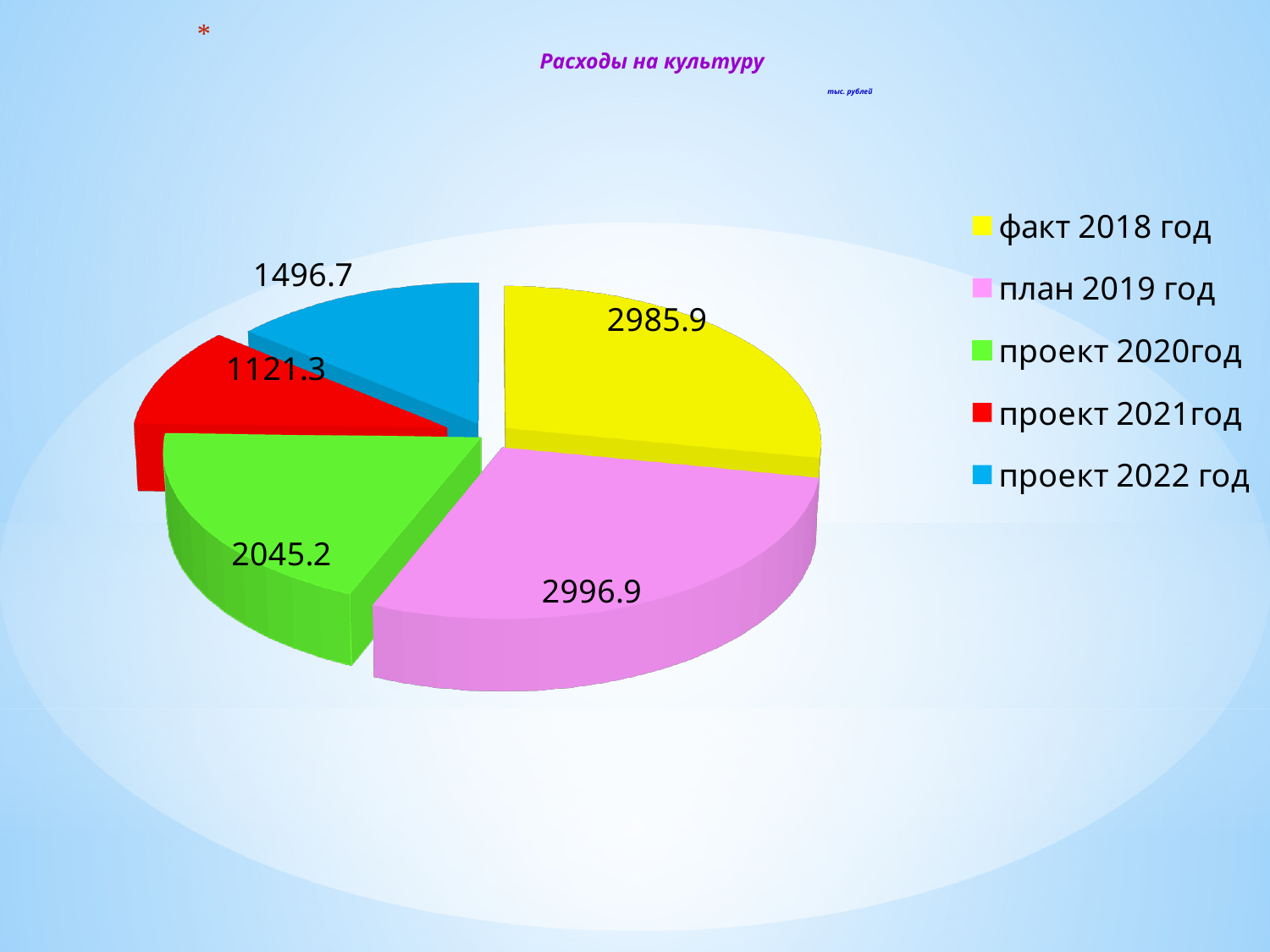
What is the value for проект 2022 год? 1496.7 How many slices does the pie chart have? 5 What is the value for проект 2021год? 1121.3 What is the value for проект 2020год? 2045.2 What kind of chart is shown on the slide? Pie chart What is the difference between the values for проект 2020год and проект 2022 год? 548.5 Which category has the smallest value? проект 2021год What is the value for факт 2018 год? 2985.9 Which is larger, the value for проект 2020год or the value for проект 2022 год? проект 2020год Which category has the largest value? план 2019 год What is the value for план 2019 год? 2996.9 What is the title of the chart? Расходы на культуру